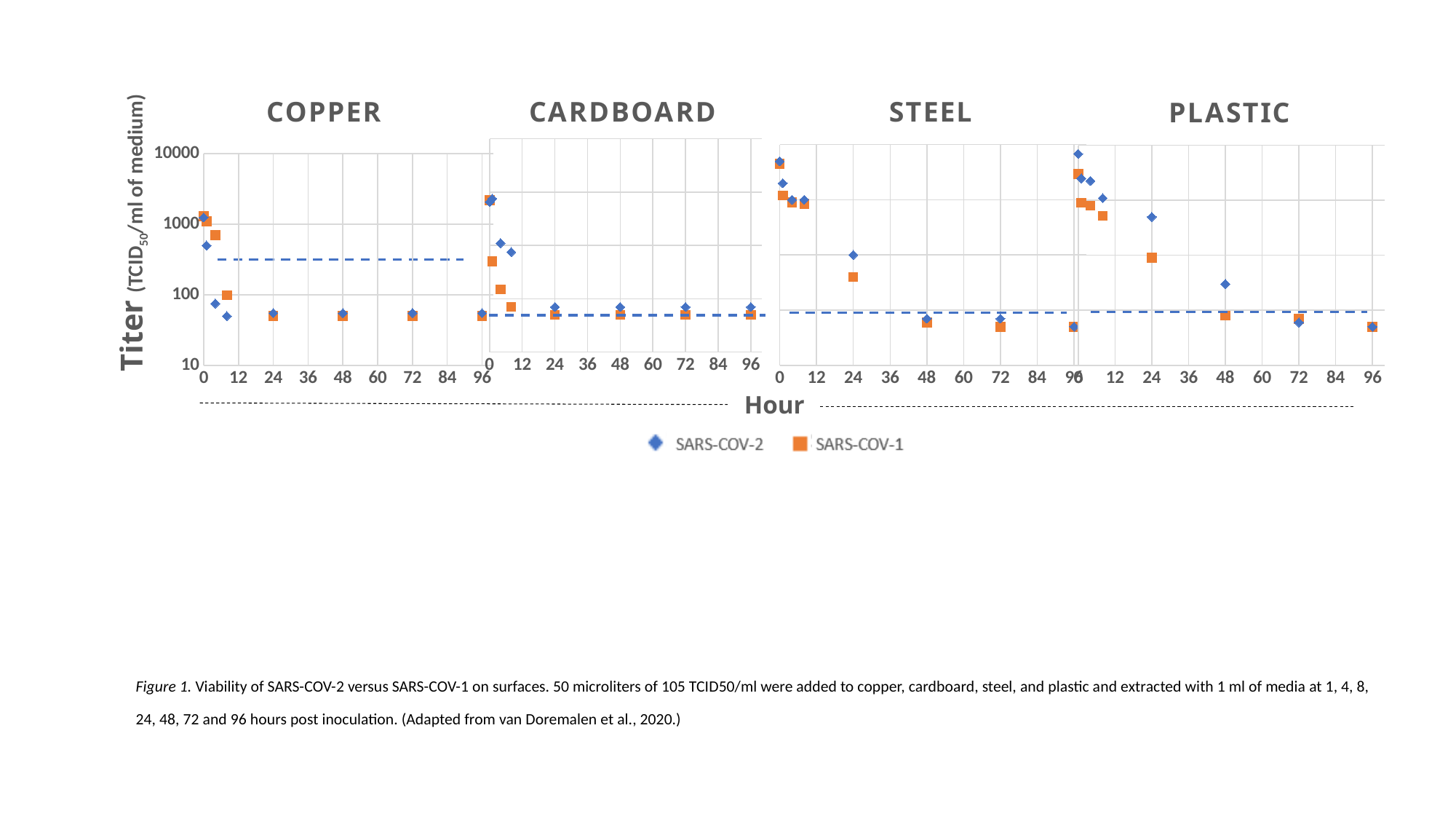
In the STEEL chart, which series has the larger value at 24 hours, SARS-COV-2 or SARS-COV-1? SARS-COV-2 In the CARDBOARD chart, is the SARS-COV-1 value at 72 hours greater or less than 100? less What are the titles of the four charts on the slide, from left to right? COPPER, CARDBOARD, STEEL, PLASTIC In the PLASTIC chart, which series has the larger value at 48 hours, SARS-COV-2 or SARS-COV-1? SARS-COV-2 In the STEEL chart, is the SARS-COV-2 value at 24 hours greater or less than 100? greater What are the two series named in the legend? SARS-COV-2 and SARS-COV-1 What kind of chart is the COPPER chart? scatter chart In the PLASTIC chart, do the SARS-COV-2 values rise or fall as the hours increase? fall How many series does the legend list for the charts? 2 In the PLASTIC chart, is the SARS-COV-2 value at 48 hours greater or less than 100? greater In the PLASTIC chart, at which hour is the SARS-COV-2 value highest? 0